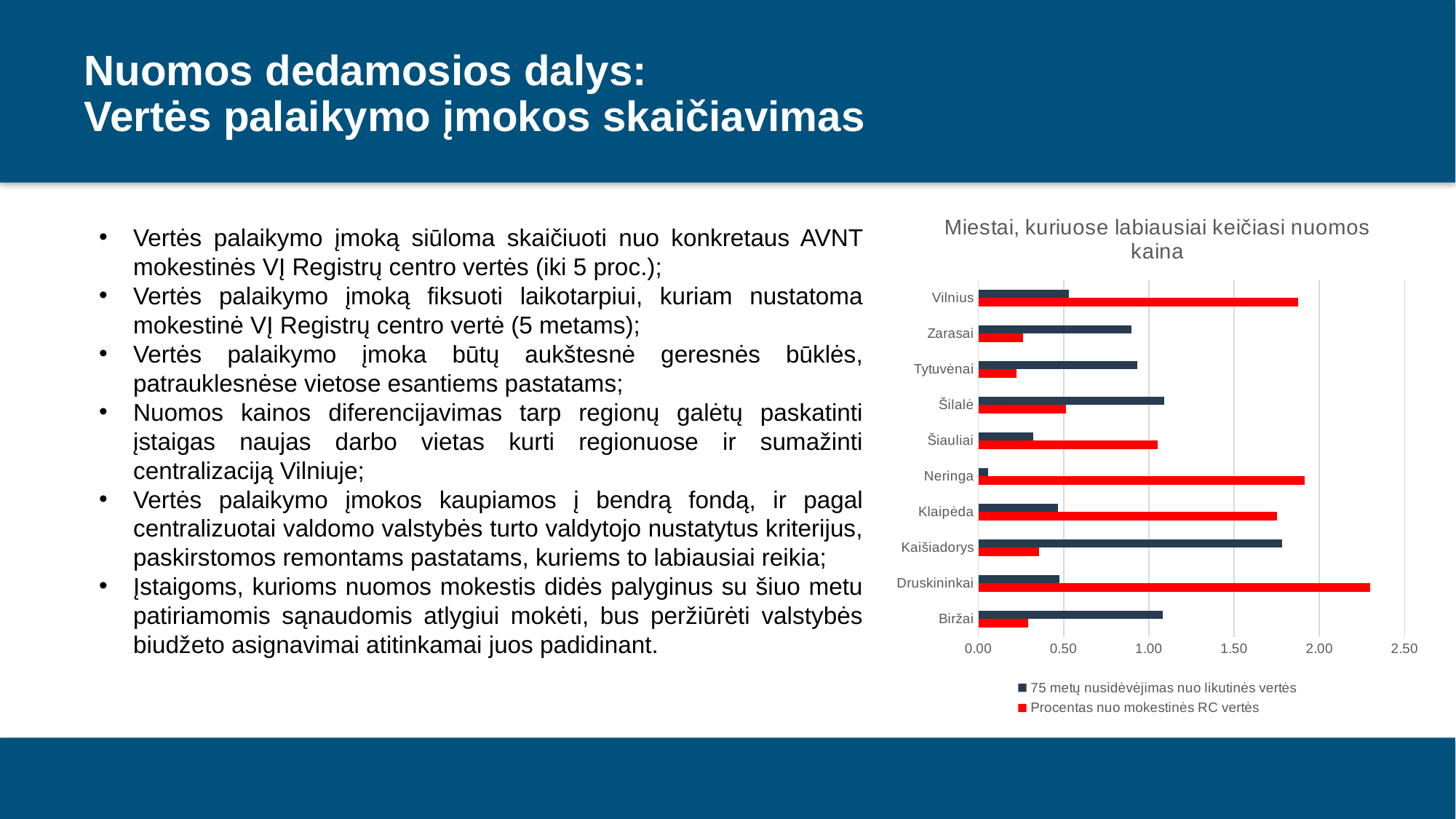
Which city has the larger 'Procentas nuo mokestinės RC vertės' value, Zarasai or Šiauliai? Šiauliai How many series does the chart legend list? 2 What kind of chart is shown on the slide? Bar chart Is the '75 metų nusidėvėjimas nuo likutinės vertės' value for Vilnius greater or less than 1.00? less Which colour represents the series 'Procentas nuo mokestinės RC vertės'? Red For Neringa, which series has the larger value: '75 metų nusidėvėjimas nuo likutinės vertės' or 'Procentas nuo mokestinės RC vertės'? Procentas nuo mokestinės RC vertės Which city has the highest value for 'Procentas nuo mokestinės RC vertės'? Druskininkai How many cities are listed on the chart's vertical axis? 10 Is the 'Procentas nuo mokestinės RC vertės' value for Druskininkai greater or less than 2.00? greater Which city has the highest value for '75 metų nusidėvėjimas nuo likutinės vertės'? Kaišiadorys What is the title of the chart? Miestai, kuriuose labiausiai keičiasi nuomos kaina Which city has the lowest value for '75 metų nusidėvėjimas nuo likutinės vertės'? Neringa